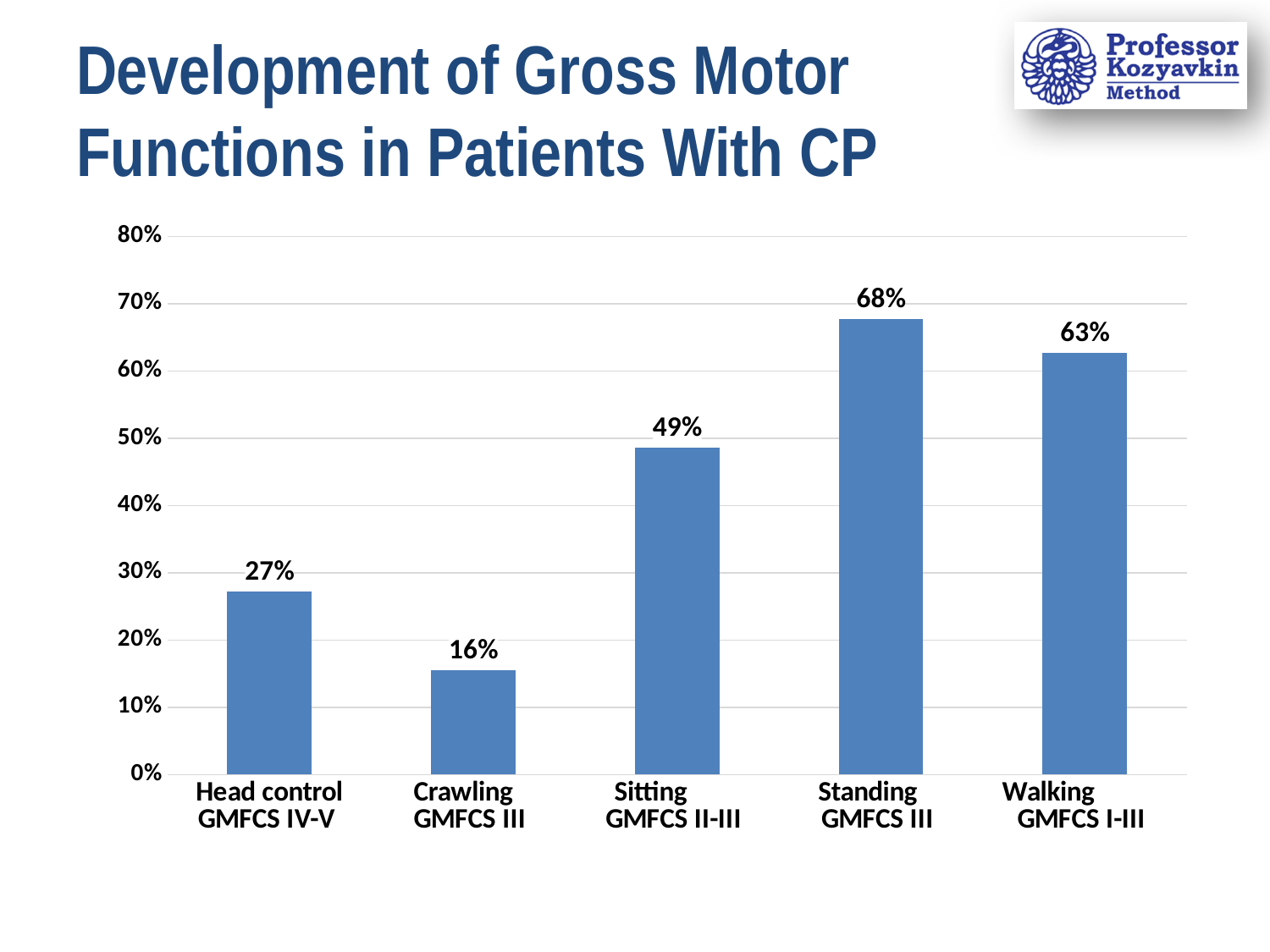
What is the value for Head control GMFCS IV-V? 27% What is the difference between the values for Sitting GMFCS II-III and Crawling GMFCS III? 33% What is the value for Walking GMFCS I-III? 63% What is the difference between the values for Standing GMFCS III and Walking GMFCS I-III? 5% Which category has the lowest value? Crawling GMFCS III What kind of chart is shown on the slide? Bar chart Which category has the highest value? Standing GMFCS III What is the title of the slide? Development of Gross Motor Functions in Patients With CP What is the value for Sitting GMFCS II-III? 49% What is the value for Crawling GMFCS III? 16% Which is larger, the value for Head control GMFCS IV-V or the value for Crawling GMFCS III? Head control GMFCS IV-V How many categories are shown on the chart? 5